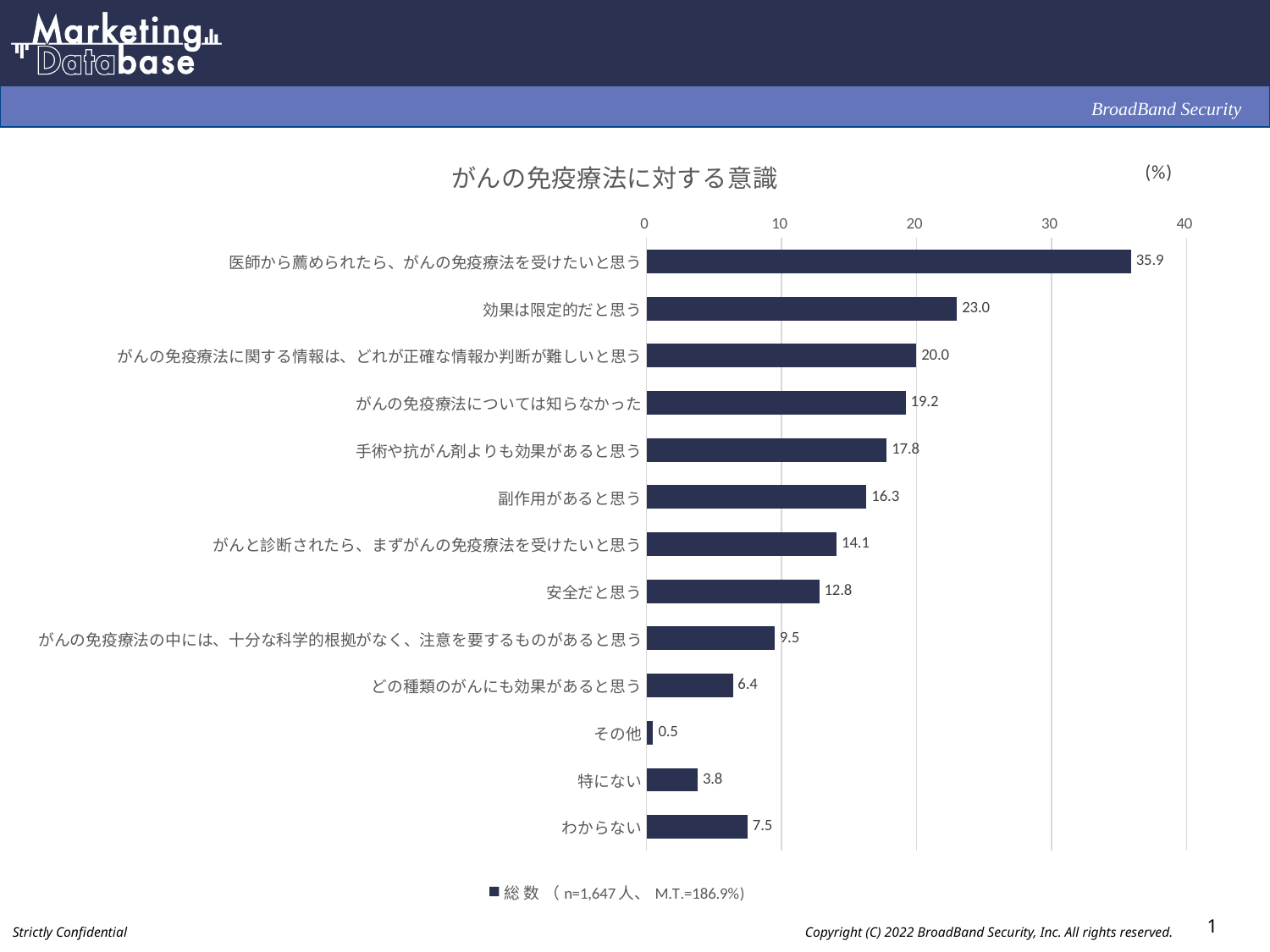
Is the value for 「がんの免疫療法に関する情報は、どれが正確な情報か判断が難しいと思う」 greater or less than 10? greater What is the title of the chart? がんの免疫療法に対する意識 Which is larger, the value for 「安全だと思う」 or the value for 「副作用があると思う」? 副作用があると思う How many categories are shown in the chart? 13 What kind of chart is shown on the slide? bar chart Which category has the lowest value? その他 What is the value for 「効果は限定的だと思う」? 23.0 What is the value for 「がんの免疫療法については知らなかった」? 19.2 Which category has the highest value? 医師から薦められたら、がんの免疫療法を受けたいと思う What is the difference between the values for 「医師から薦められたら、がんの免疫療法を受けたいと思う」 and 「効果は限定的だと思う」? 12.9 How many series does the legend list? 1 What is the sample size (n) shown in the legend? 1,647人